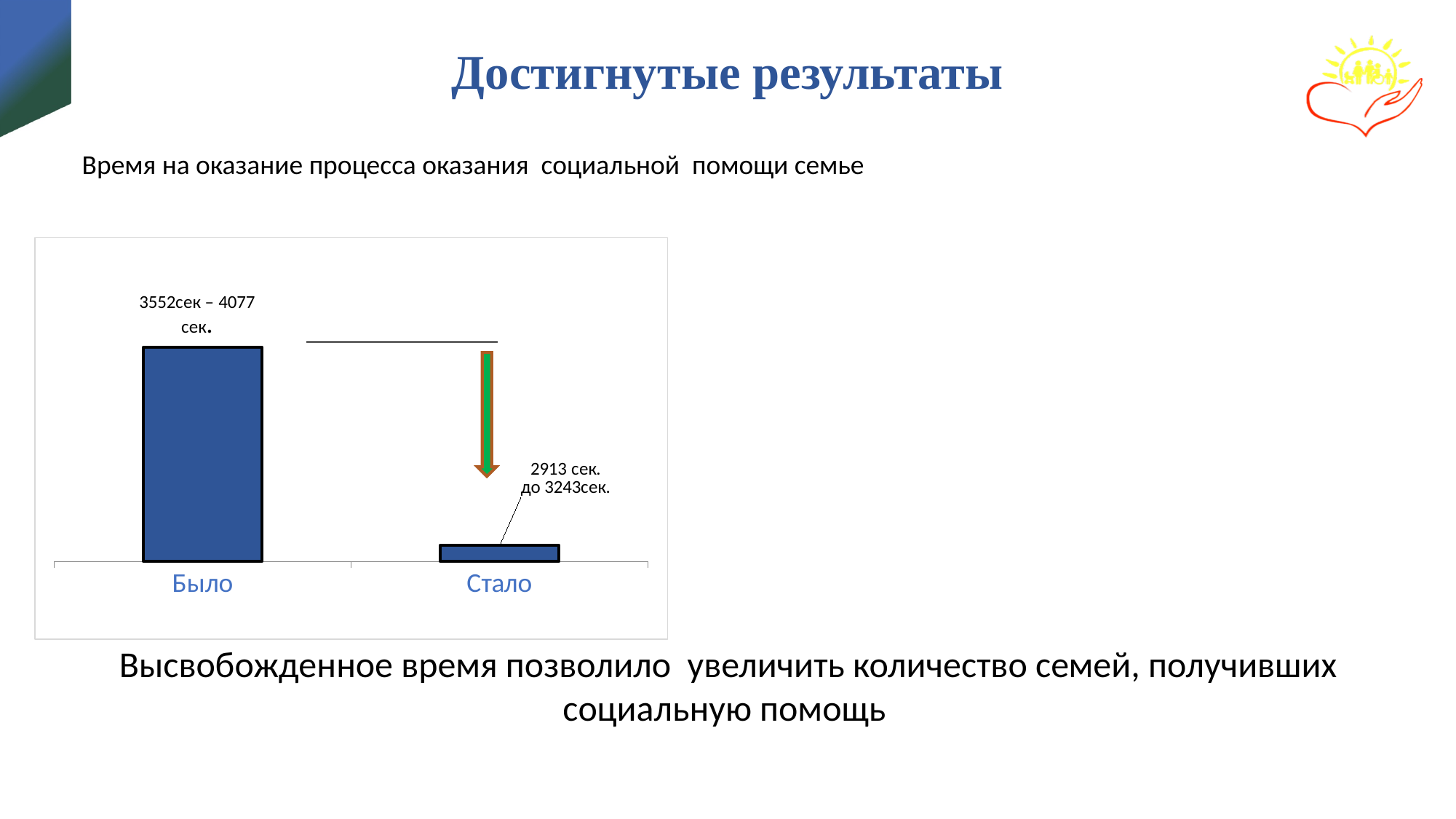
Which category has the lowest bar in the chart? Стало What data label is printed above the Было bar? 3552сек – 4077 сек. What data label is printed next to the Стало bar? 2913 сек. до 3243сек. What colour are the bars in the chart? blue Which category has the highest bar in the chart? Было How many categories are shown on the x axis of the chart? 2 Do the bar values rise or fall from Было to Стало? fall What are the two category labels on the x axis, from left to right? Было, Стало What kind of chart is shown on the slide? bar chart Which category has the taller bar, Было or Стало? Было